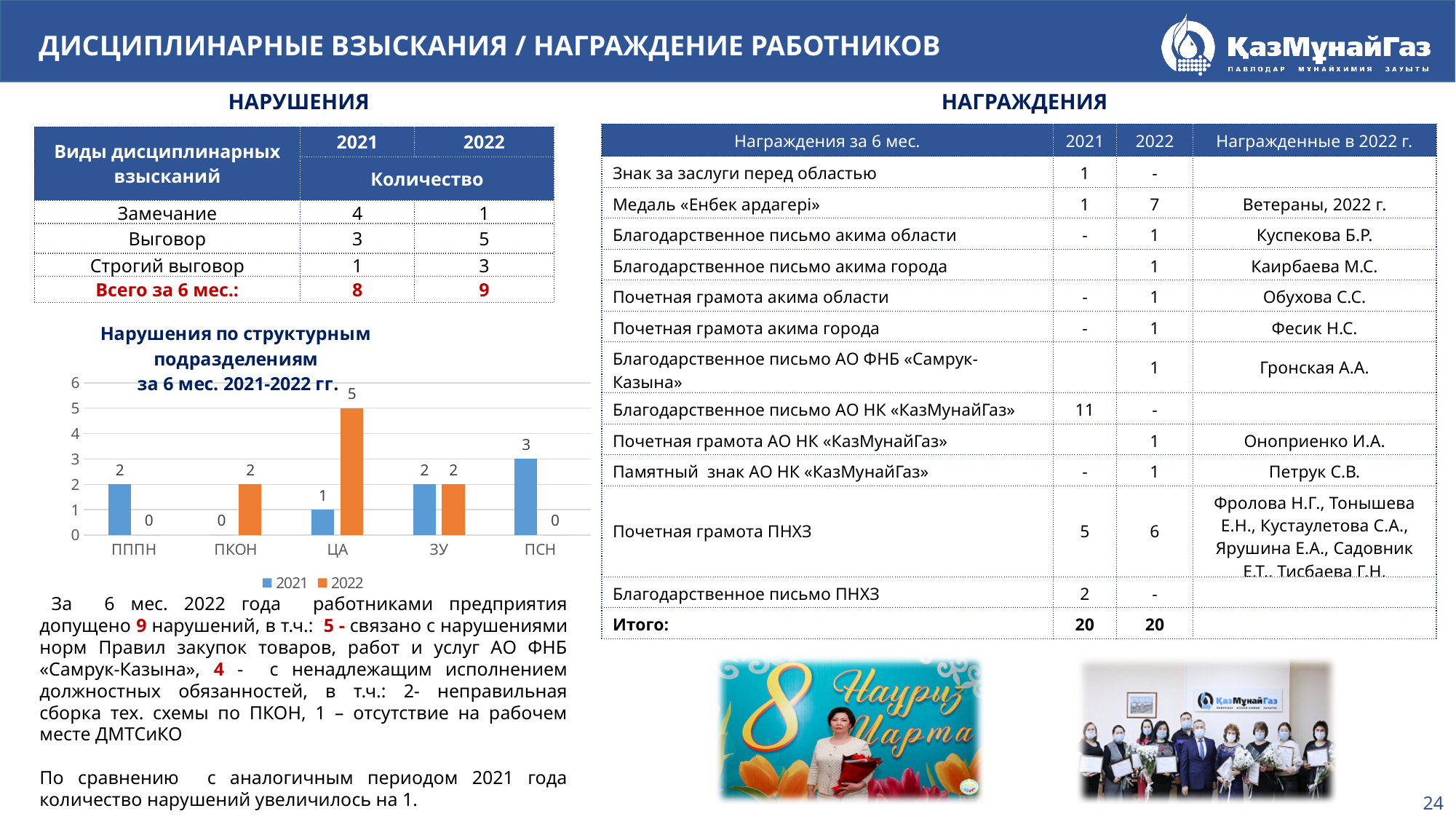
What type of chart is shown on the slide? bar chart In the chart, which is larger for ПППН: the 2021 value or the 2022 value? 2021 In the chart, what is the value for ПППН in 2022? 0 How many categories are shown on the x axis of the chart? 5 How many series does the chart's legend list? 2 In the chart, which category has the highest value for 2022? ЦА In the chart, what is the value for ПСН in 2021? 3 In the chart, what is the value for ПКОН in 2022? 2 What is the title of the chart? Нарушения по структурным подразделениям за 6 мес. 2021-2022 гг. In the chart, which category has the highest value for 2021? ПСН In the chart, what is the value for ЦА in 2022? 5 In the chart, what is the difference between the 2022 and 2021 values for ЦА? 4